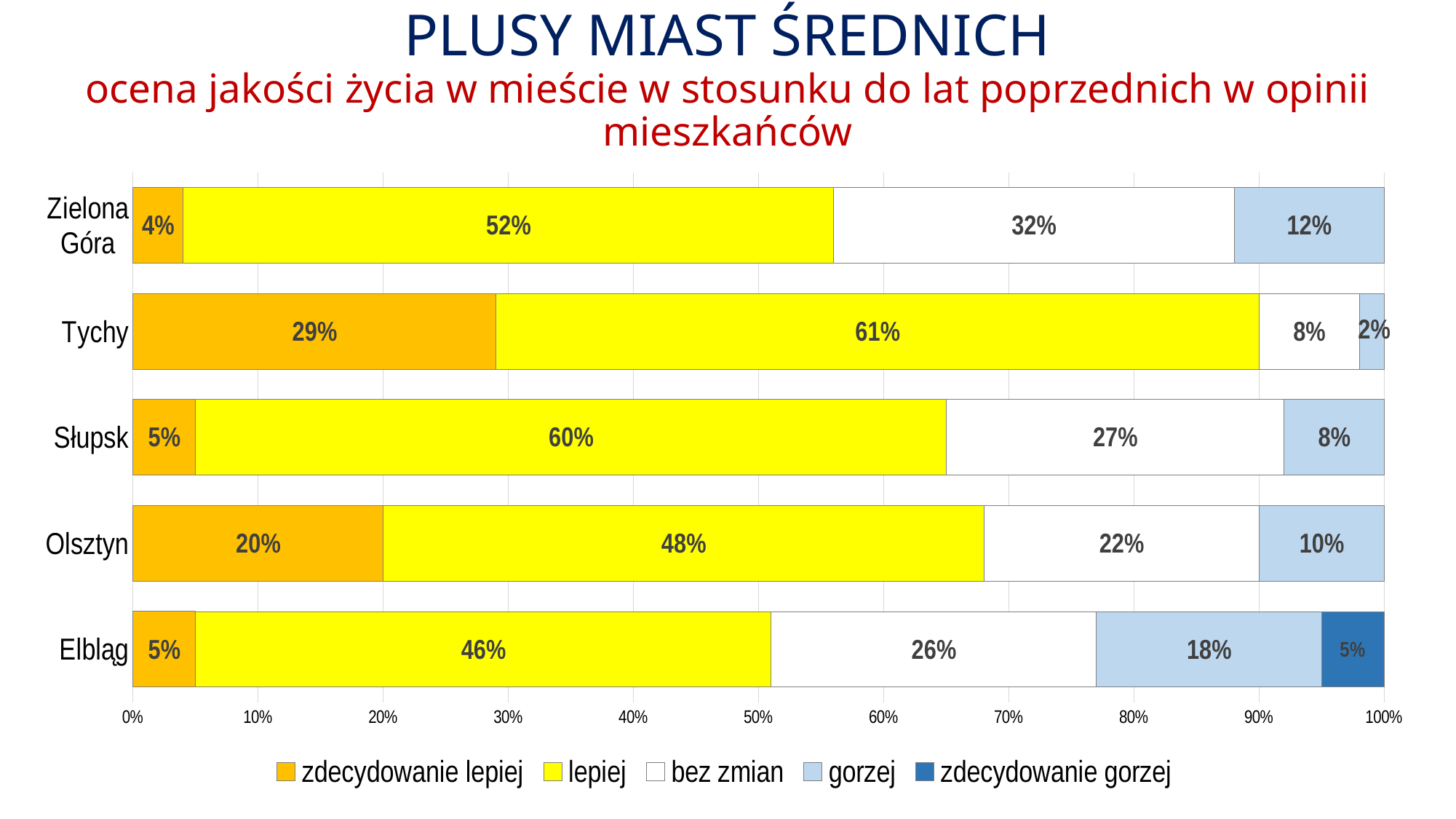
What kind of chart is shown on the slide? Stacked bar chart What is the difference between the "lepiej" values for Słupsk and Olsztyn? 12% What is the "gorzej" value for Elbląg? 18% Which city has the highest "zdecydowanie lepiej" value? Tychy Which city is the only one with a "zdecydowanie gorzej" segment shown? Elbląg Which city has the lowest "zdecydowanie lepiej" value? Zielona Góra How many cities are shown on the chart? 5 What percentage of Tychy residents answered "lepiej"? 61% How many series does the legend list? 5 What is the "bez zmian" value for Zielona Góra? 32% What is the total of the stacked bar for Elbląg? 100% Which is larger: the "bez zmian" value for Słupsk or for Elbląg? Słupsk